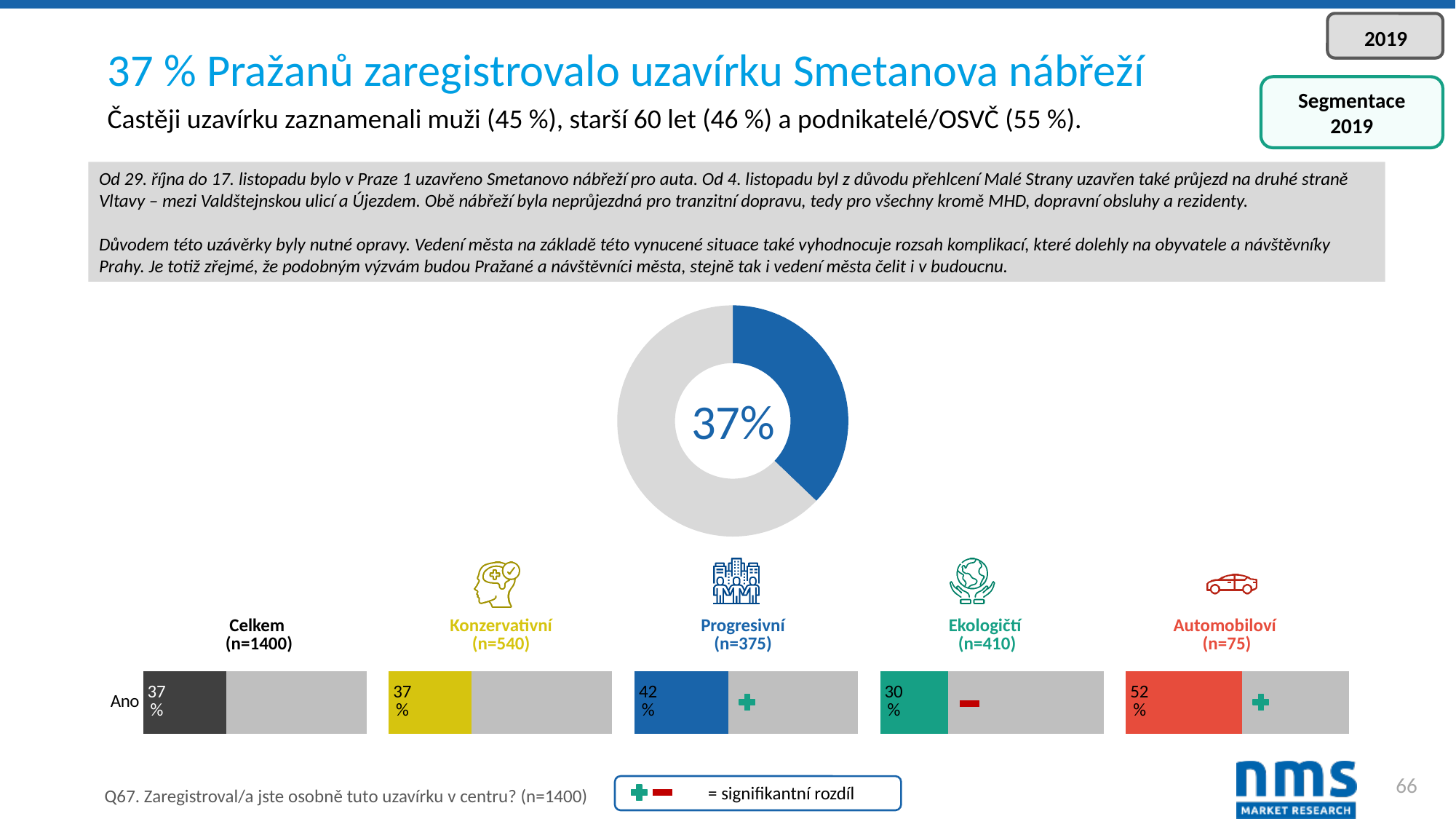
In the segment bars at the bottom, which segment has the highest value? Automobiloví In the segment bars at the bottom, which is larger, the value for Progresivní or the value for Konzervativní? Progresivní In the segment bars at the bottom, what is the difference between the values for Automobiloví and Ekologičtí? 22 percentage points What kind of chart is the large chart in the middle of the slide? donut chart In the segment bars at the bottom, what is the value for Progresivní? 42% In the segment bars at the bottom, what is the value for Konzervativní? 37% In the donut chart, what percentage is shown in the centre? 37% How many segment groups (including Celkem) are shown in the bar chart at the bottom? 5 In the segment bars at the bottom, what is the value for Automobiloví? 52% In the segment bars at the bottom, what is the value for Ekologičtí? 30% In the segment bars at the bottom, which segment has the lowest value? Ekologičtí In the segment bars at the bottom, what is the sample size (n) shown for Automobiloví? n=75